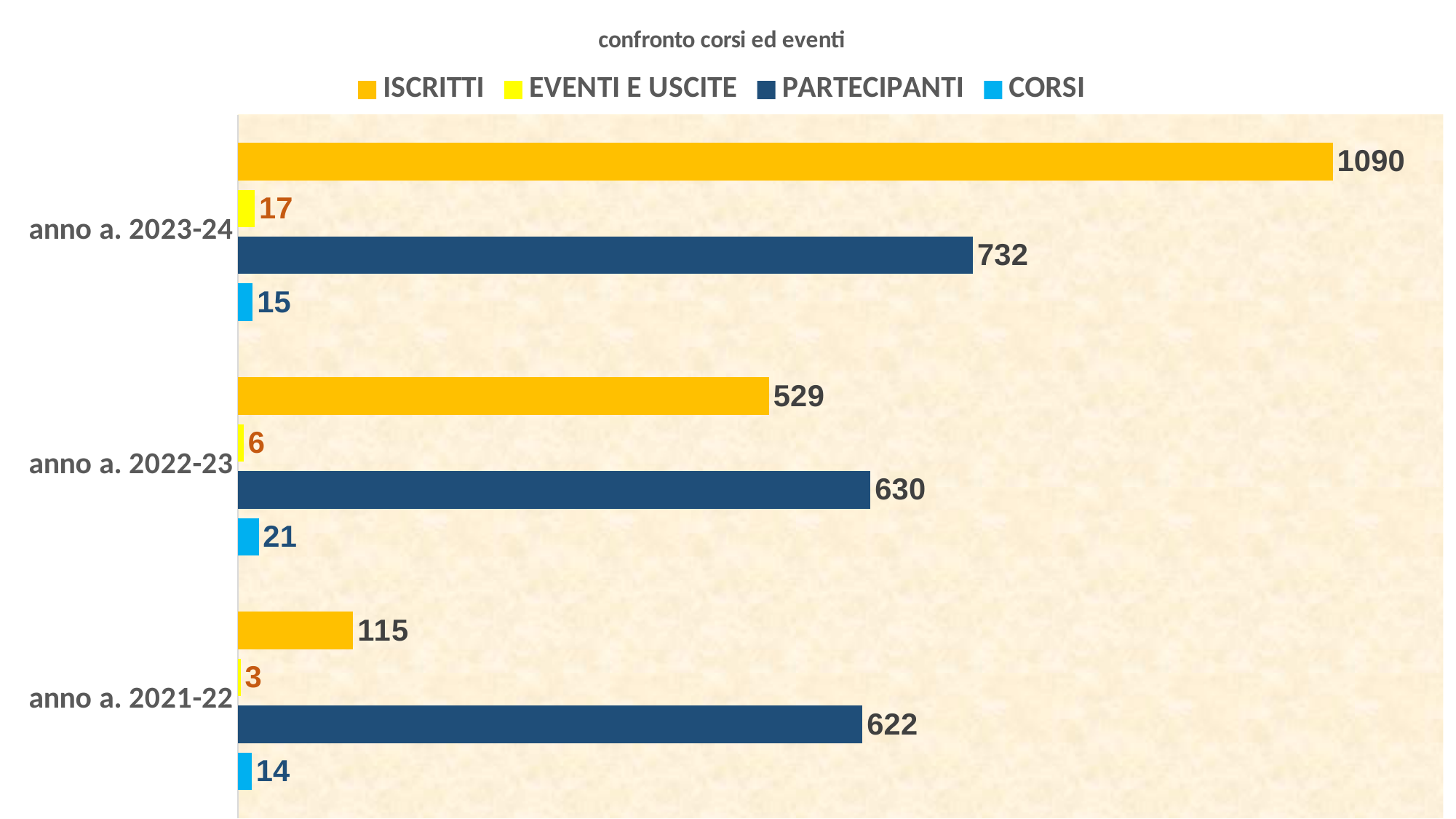
Which is larger: PARTECIPANTI for anno a. 2021-22 or ISCRITTI for anno a. 2021-22? PARTECIPANTI for anno a. 2021-22 What is the ISCRITTI value for anno a. 2023-24? 1090 How many series does the legend list? 4 What is the CORSI value for anno a. 2021-22? 14 Which year has the lowest CORSI value? anno a. 2021-22 How many years (categories) are shown on the chart? 3 What is the title of the chart? confronto corsi ed eventi What is the difference between the ISCRITTI values for anno a. 2023-24 and anno a. 2022-23? 561 What is the PARTECIPANTI value for anno a. 2022-23? 630 Which year has the highest ISCRITTI value? anno a. 2023-24 What is the EVENTI E USCITE value for anno a. 2022-23? 6 What kind of chart is shown? bar chart